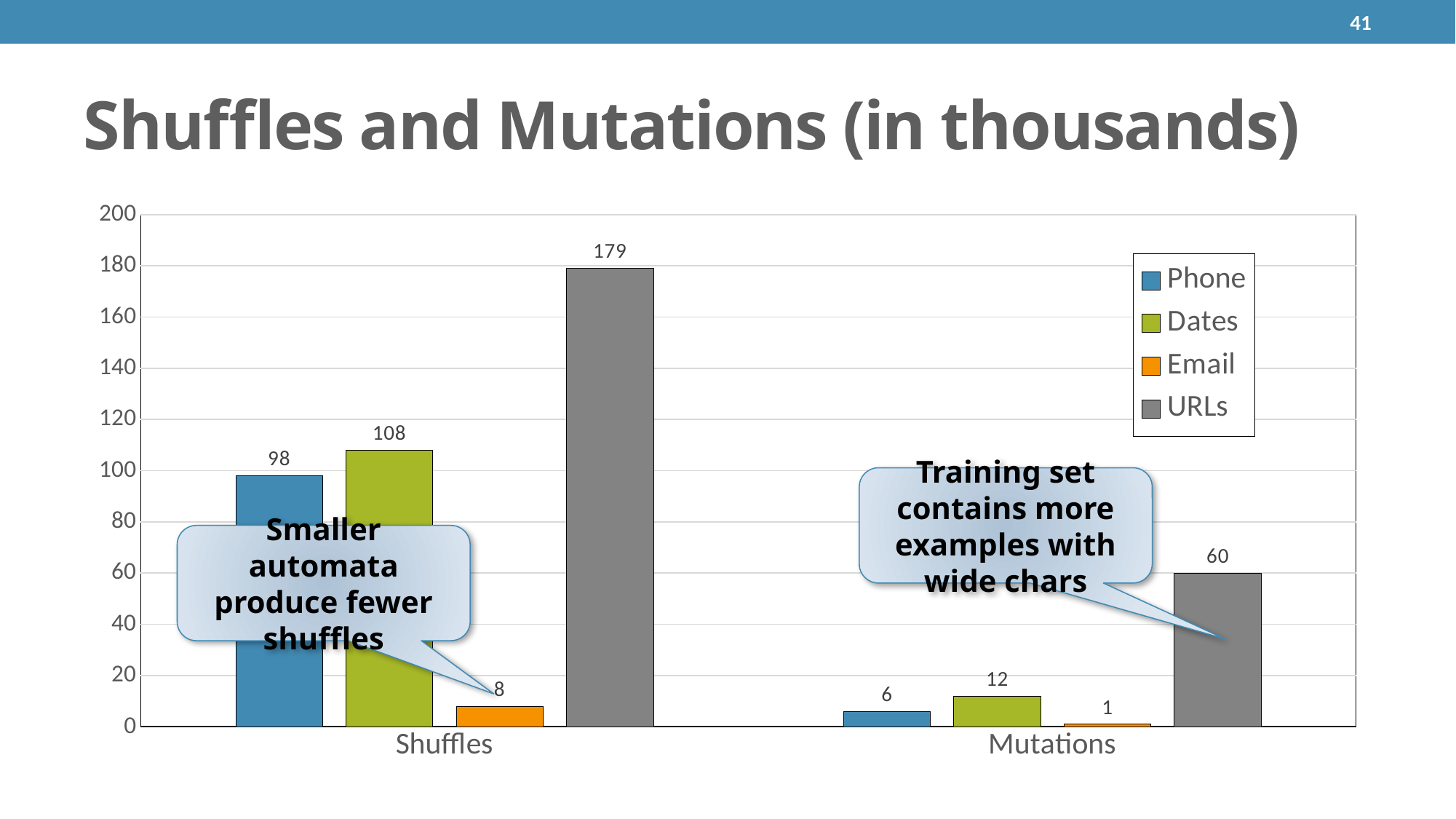
Which series has the highest value in the Shuffles category? URLs What is the value for Email in the Shuffles category? 8 How many series does the legend list? 4 How many categories are shown on the x axis? 2 What is the difference between the Dates and Phone values in the Shuffles category? 10 Which is larger, the Phone value for Shuffles or the Phone value for Mutations? Shuffles What is the value for Dates in the Mutations category? 12 Is the value for Dates in the Shuffles category greater or less than 100? greater Which series has the lowest value in the Mutations category? Email What is the difference between the URLs values for Shuffles and Mutations? 119 What kind of chart is shown on the slide? bar chart What is the value for URLs in the Shuffles category? 179